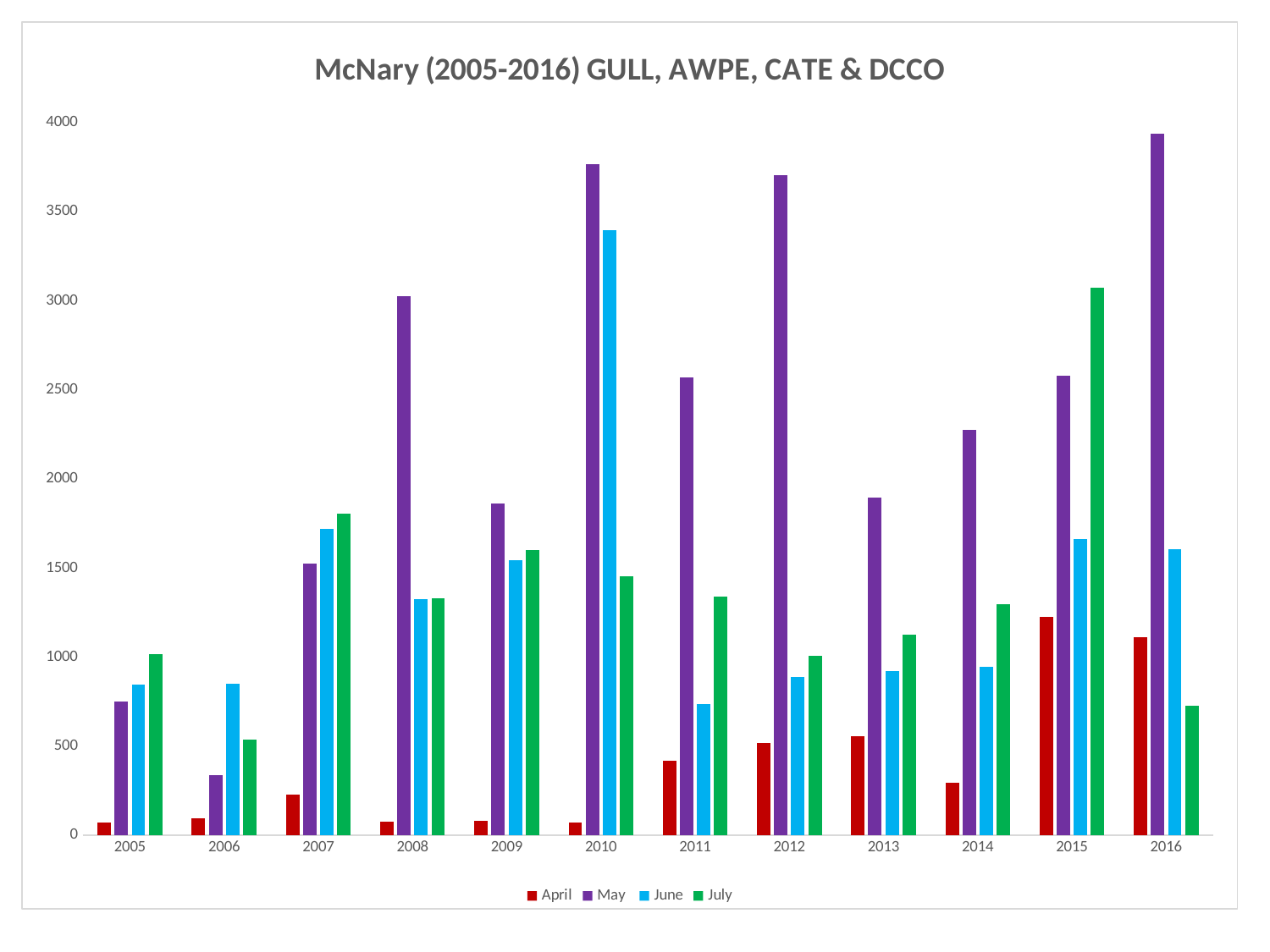
How many years are shown on the x axis? 12 In 2015, which is larger, the July value or the May value? July Which series is shown in green in the legend? July Is the May value for 2010 greater or less than 3500? greater Which year has the lowest May value? 2006 What kind of chart is shown on the slide? bar chart Which year has the highest June value? 2010 How many series does the legend list? 4 Which year has the highest July value? 2015 Which year has the highest May value? 2016 Is the July value for 2016 greater or less than 1000? less What is the title of the chart? McNary (2005-2016) GULL, AWPE, CATE & DCCO